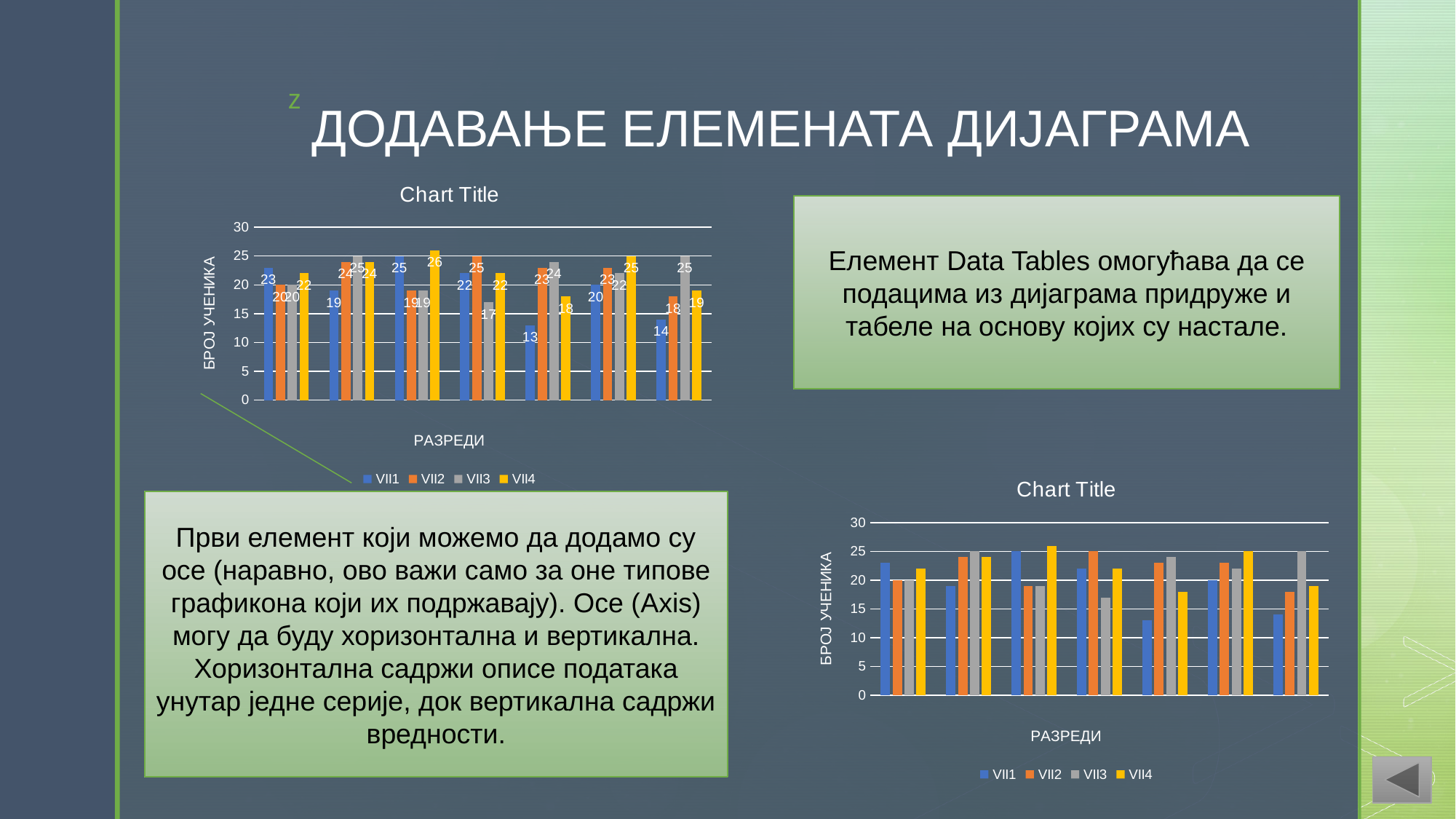
In the top-left chart, what is the lowest data label shown on any bar? 13 In the top-left chart, what is the value of the VII1 bar in the first group of bars from the left? 23 In the bottom-right chart, is the value of the VII1 bar in the fifth group of bars from the left greater or less than 15? less In the top-left chart, what is the value of the VII4 bar in the third group of bars from the left? 26 What kind of chart is the chart in the bottom-right of the slide? bar chart In the top-left chart, what is the title shown on the vertical axis? БРОЈ УЧЕНИКА In the top-left chart, what is the difference between the VII1 bar and the VII2 bar in the first group of bars from the left? 3 In the top-left chart, how many series does the legend list? 4 In the bottom-right chart, what are the legend entries? VII1, VII2, VII3, VII4 In the top-left chart, what is the highest data label shown on any bar? 26 What kind of chart is the chart in the top-left of the slide? bar chart In the bottom-right chart, how many groups of bars are plotted along the x axis? 7